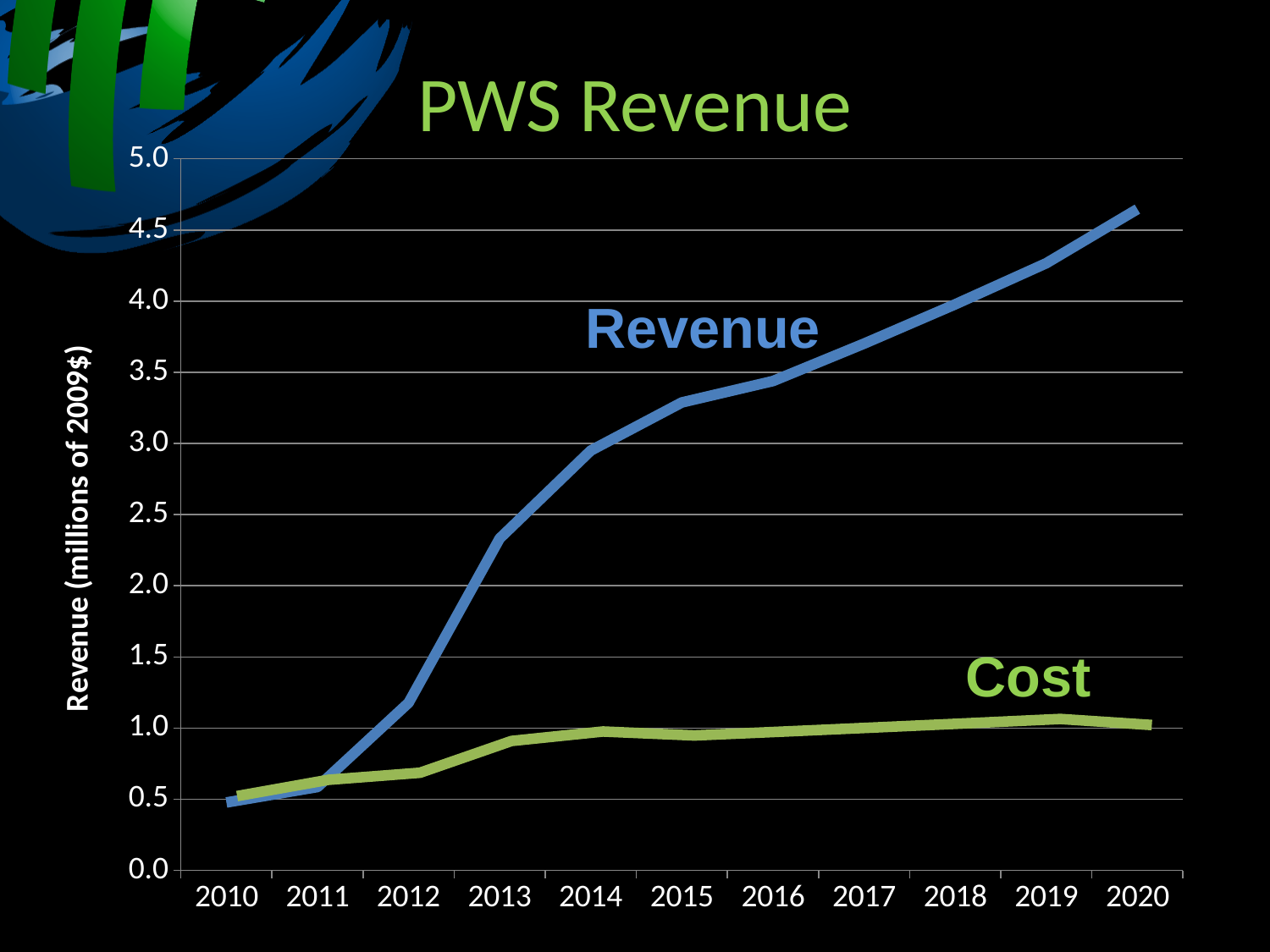
In which year is Revenue highest? 2020 Is the Cost value for 2020 greater or less than 1.5? less What is the title of the chart? PWS Revenue Is the Revenue value for 2013 greater or less than 2.0? greater In which year is Revenue lowest? 2010 How many years are shown along the x axis? 11 What is the label on the y axis? Revenue (millions of 2009$) In 2020, which is larger, Revenue or Cost? Revenue Is the Revenue value for 2019 greater or less than 4.0? greater How many series are plotted on the chart? 2 Does the Revenue line rise or fall from 2010 to 2020? rise What kind of chart is shown on the slide? line chart